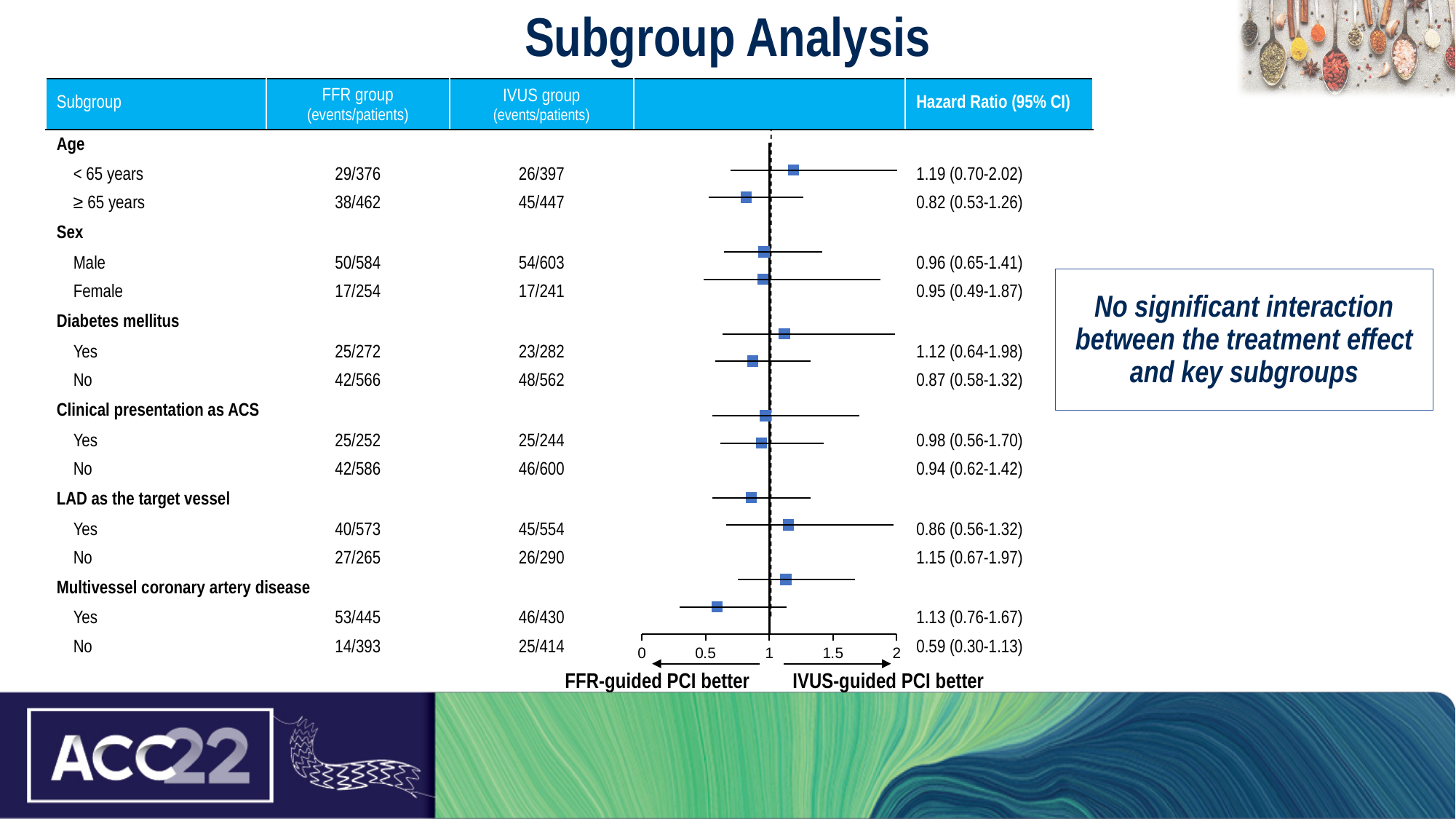
What kind of chart is shown on the slide? Forest plot Which has the larger hazard ratio point estimate: Diabetes mellitus 'Yes' or Diabetes mellitus 'No'? Diabetes mellitus: Yes What label appears under the left side of the hazard ratio axis? FFR-guided PCI better Which subgroup has the highest point estimate of the hazard ratio? Age < 65 years What is the difference between the hazard ratio point estimates for < 65 years and ≥ 65 years? 0.37 Which subgroup has the lowest point estimate of the hazard ratio? Multivessel coronary artery disease: No What is the hazard ratio (95% CI) for the < 65 years subgroup? 1.19 (0.70-2.02) How many subgroup rows have a hazard ratio reported in the forest plot? 12 What is the hazard ratio (95% CI) for the Male subgroup? 0.96 (0.65-1.41) What is the highest tick value shown on the hazard ratio axis? 2 What is the hazard ratio (95% CI) for the Multivessel coronary artery disease 'No' subgroup? 0.59 (0.30-1.13) Is the hazard ratio point estimate for the ≥ 65 years subgroup greater or less than 1? less